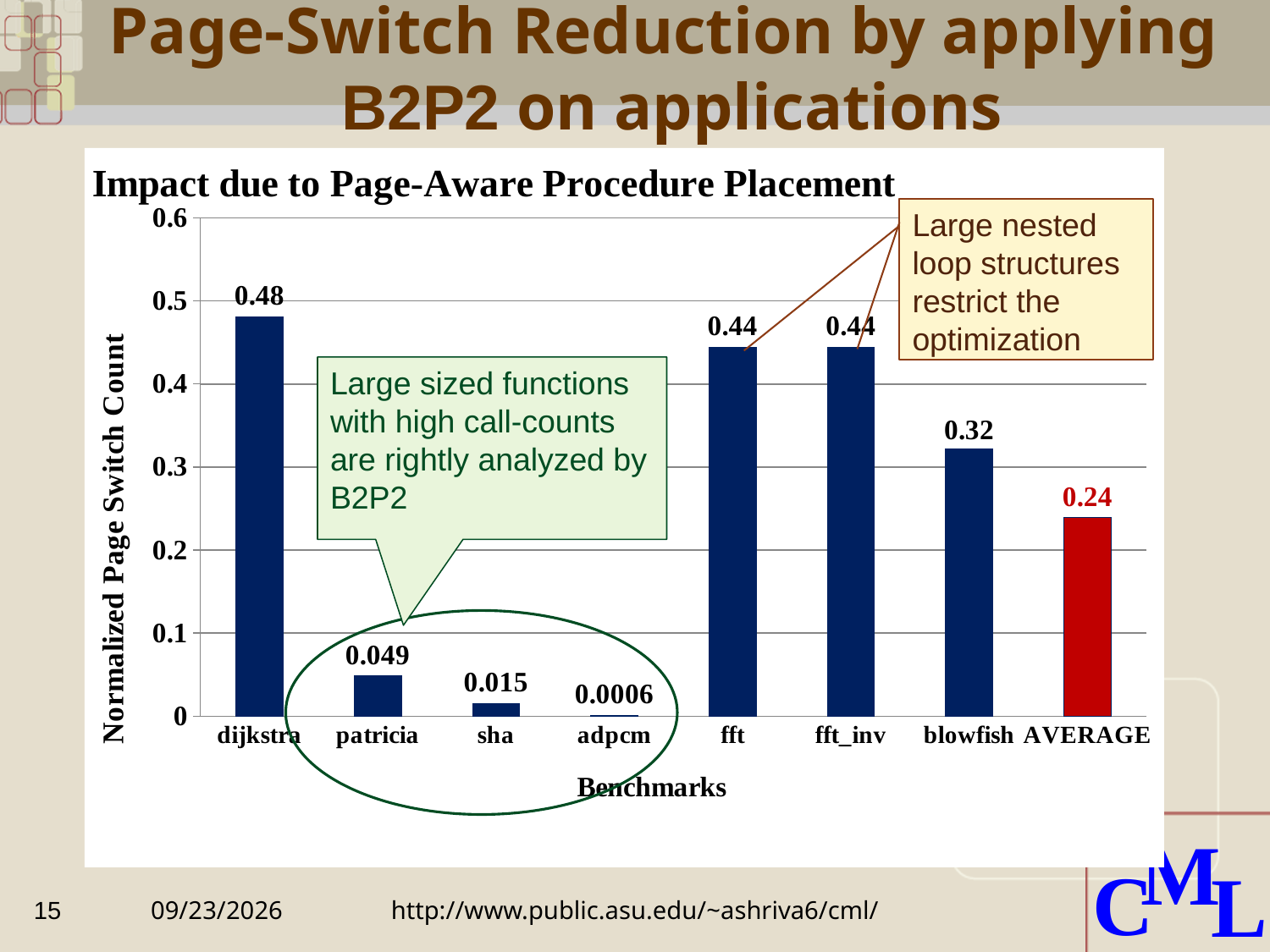
What is the normalized page switch count for blowfish? 0.32 What is the value shown for adpcm? 0.0006 Is the value for fft greater or less than 0.4? greater What is the difference between the values for dijkstra and blowfish? 0.16 What is the value shown for AVERAGE? 0.24 Which has a larger value, patricia or sha? patricia What kind of chart is shown on the slide? bar chart What is the normalized page switch count for dijkstra? 0.48 Which benchmark has the lowest normalized page switch count? adpcm How many categories are shown on the x axis? 8 Which benchmark has the highest normalized page switch count? dijkstra What is the title of the chart? Impact due to Page-Aware Procedure Placement